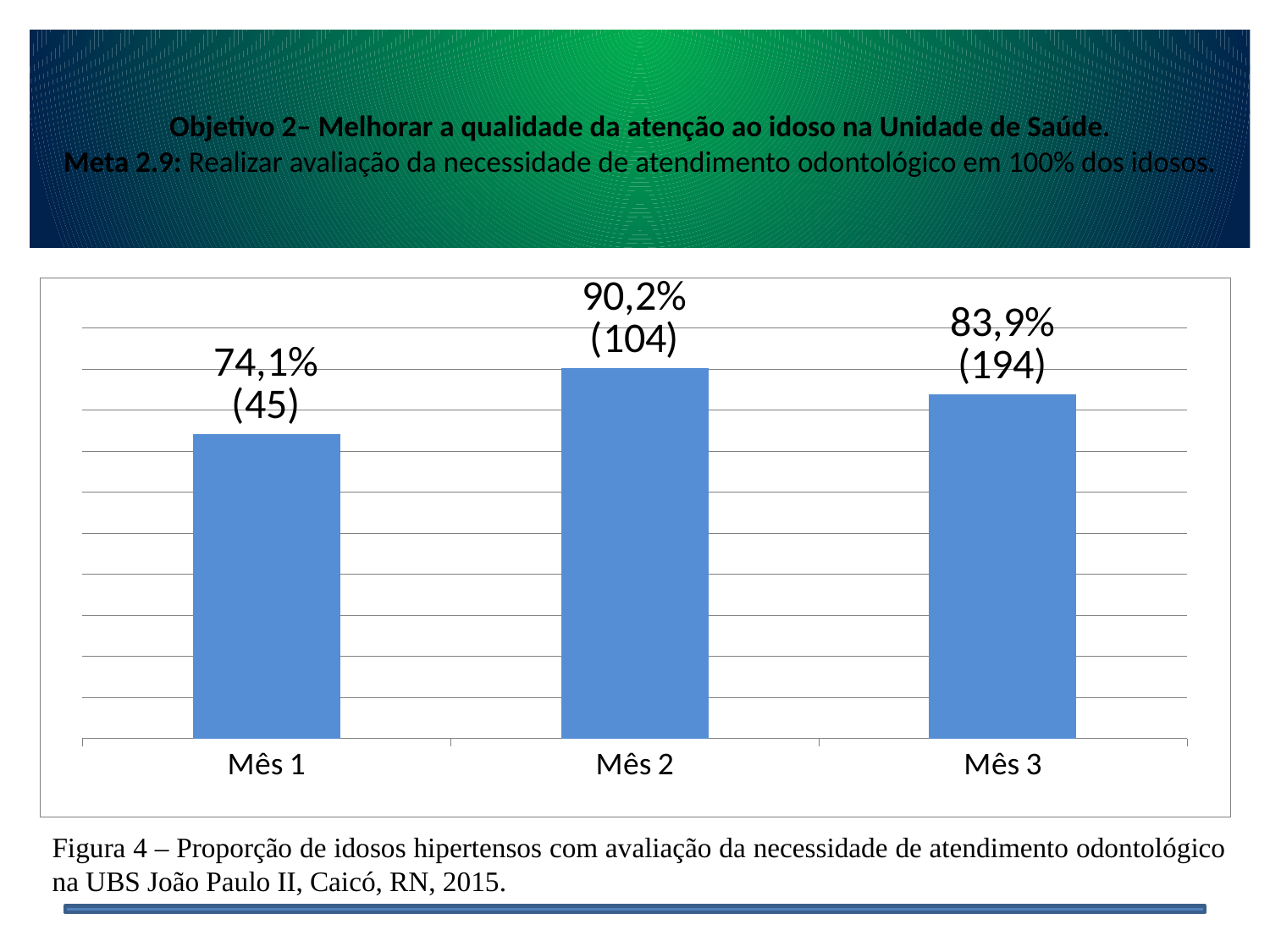
How many months (categories) are shown in the chart? 3 Which has a higher percentage, Mês 2 or Mês 3? Mês 2 What count is shown in parentheses for Mês 1? 45 What is the percentage value shown for Mês 3? 83,9% Which month has the lowest percentage? Mês 1 What is the figure number given in the caption below the chart? Figura 4 What is the percentage value shown for Mês 2? 90,2% What kind of chart is shown on the slide? Bar chart What is the difference in percentage points between Mês 2 and Mês 1? 16,1 Which month has the highest percentage? Mês 2 What count is shown in parentheses for Mês 3? 194 What is the percentage value shown for Mês 1? 74,1%